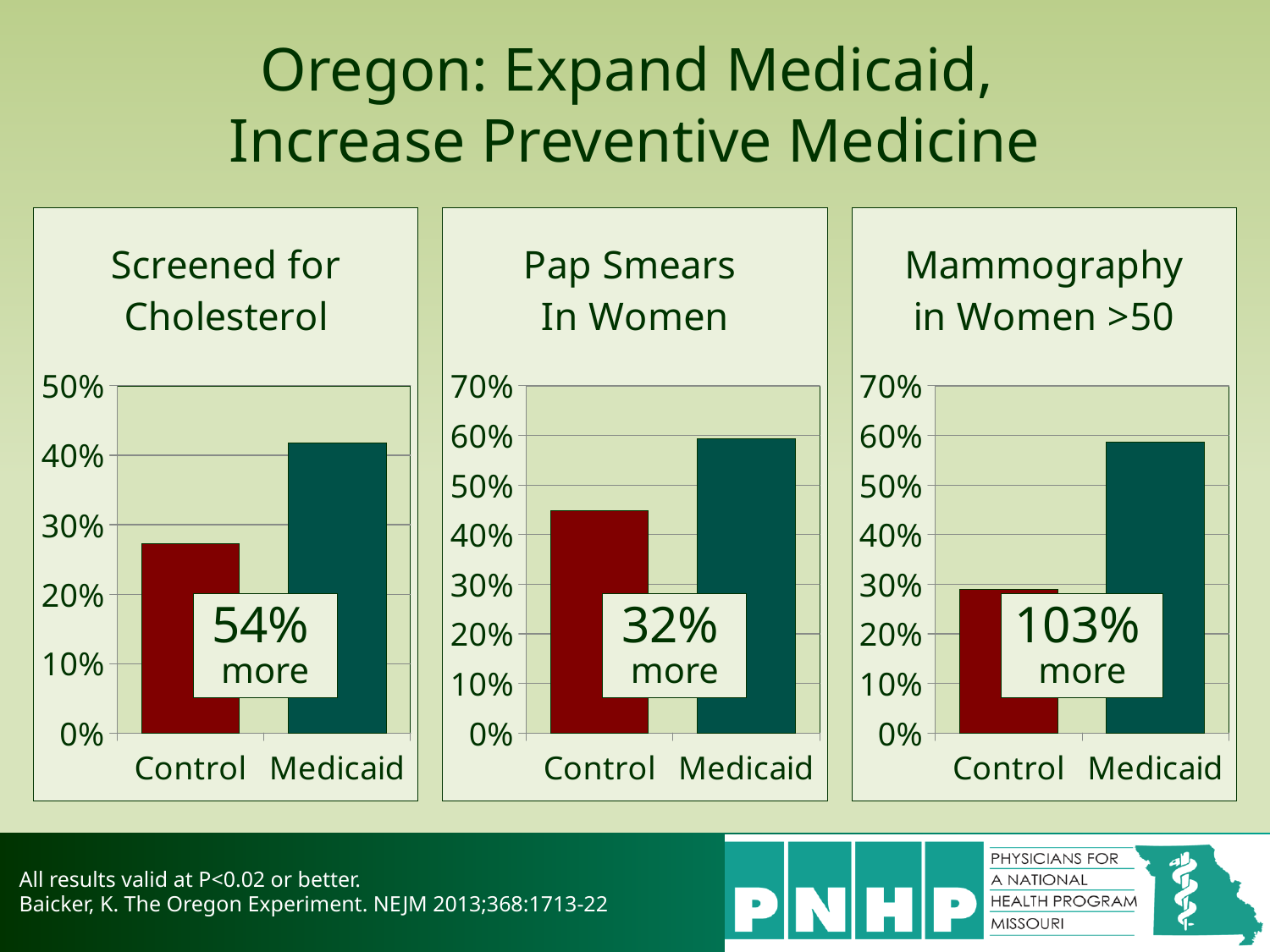
In the 'Pap Smears In Women' chart, which category is lowest? Control In the 'Screened for Cholesterol' chart, which category has the higher value, Control or Medicaid? Medicaid What kind of chart is the 'Screened for Cholesterol' chart? bar chart In the 'Mammography in Women >50' chart, is the value for Control greater or less than 20%? greater In the 'Screened for Cholesterol' chart, is the value for Medicaid greater or less than 40%? greater In the 'Screened for Cholesterol' chart, how many categories are shown? 2 What percentage increase is annotated on the 'Mammography in Women >50' chart? 103% more In the 'Pap Smears In Women' chart, is the value for Control greater or less than 40%? greater In the 'Mammography in Women >50' chart, which category is highest? Medicaid